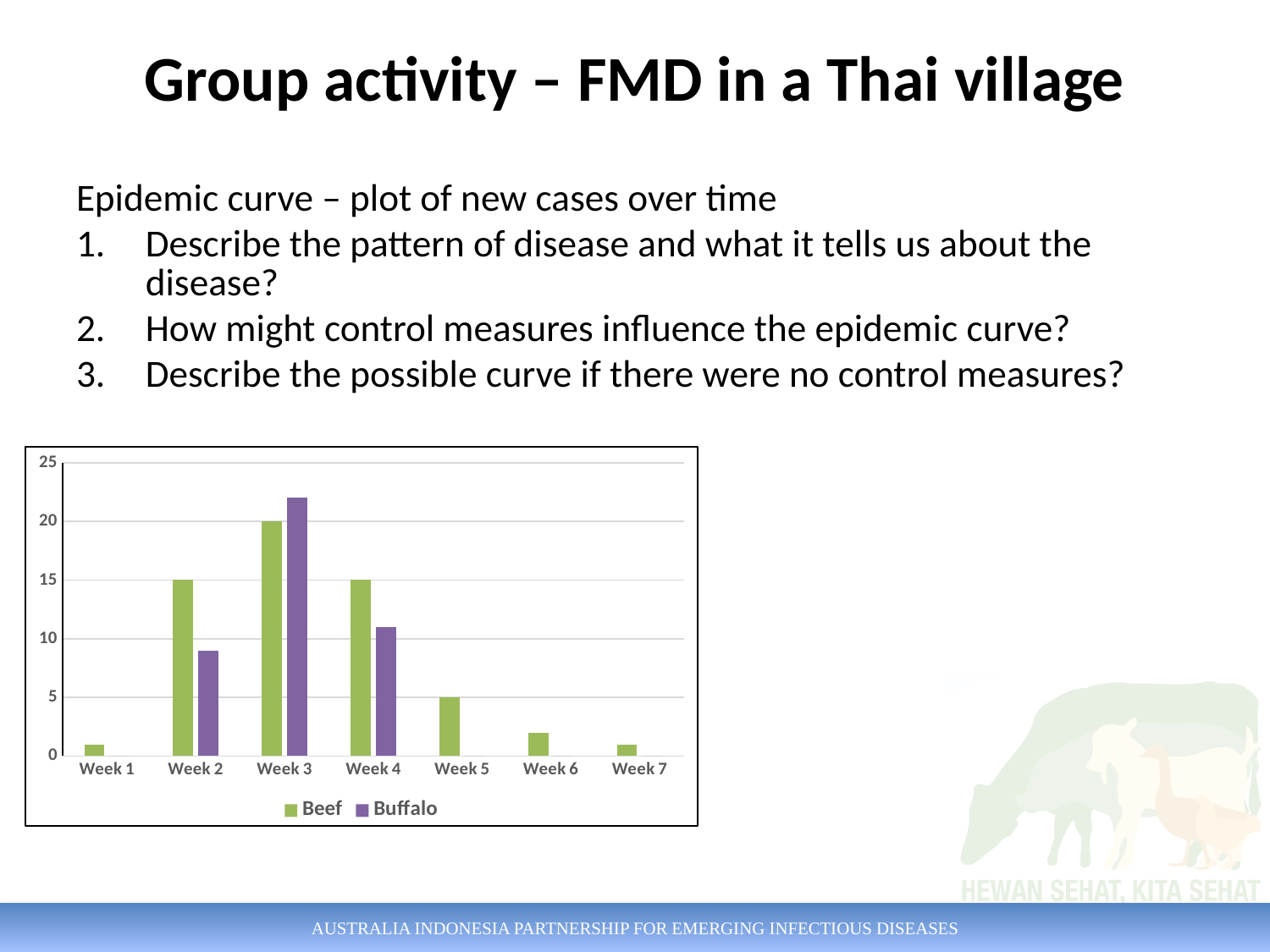
In which week is the Beef value highest? Week 3 What is the value for Beef in Week 2? 15 In which week is the Buffalo value highest? Week 3 What is the difference between the Beef values in Week 3 and Week 5? 15 Is the value for Buffalo in Week 3 greater or less than 20? greater What is the value for Beef in Week 3? 20 What is the value for Beef in Week 5? 5 How many series does the chart's legend list? 2 How many weeks are shown on the x axis of the chart? 7 What kind of chart is shown on the slide? bar chart Is the value for Buffalo in Week 2 greater or less than 10? less In Week 3, which series has the larger value, Beef or Buffalo? Buffalo